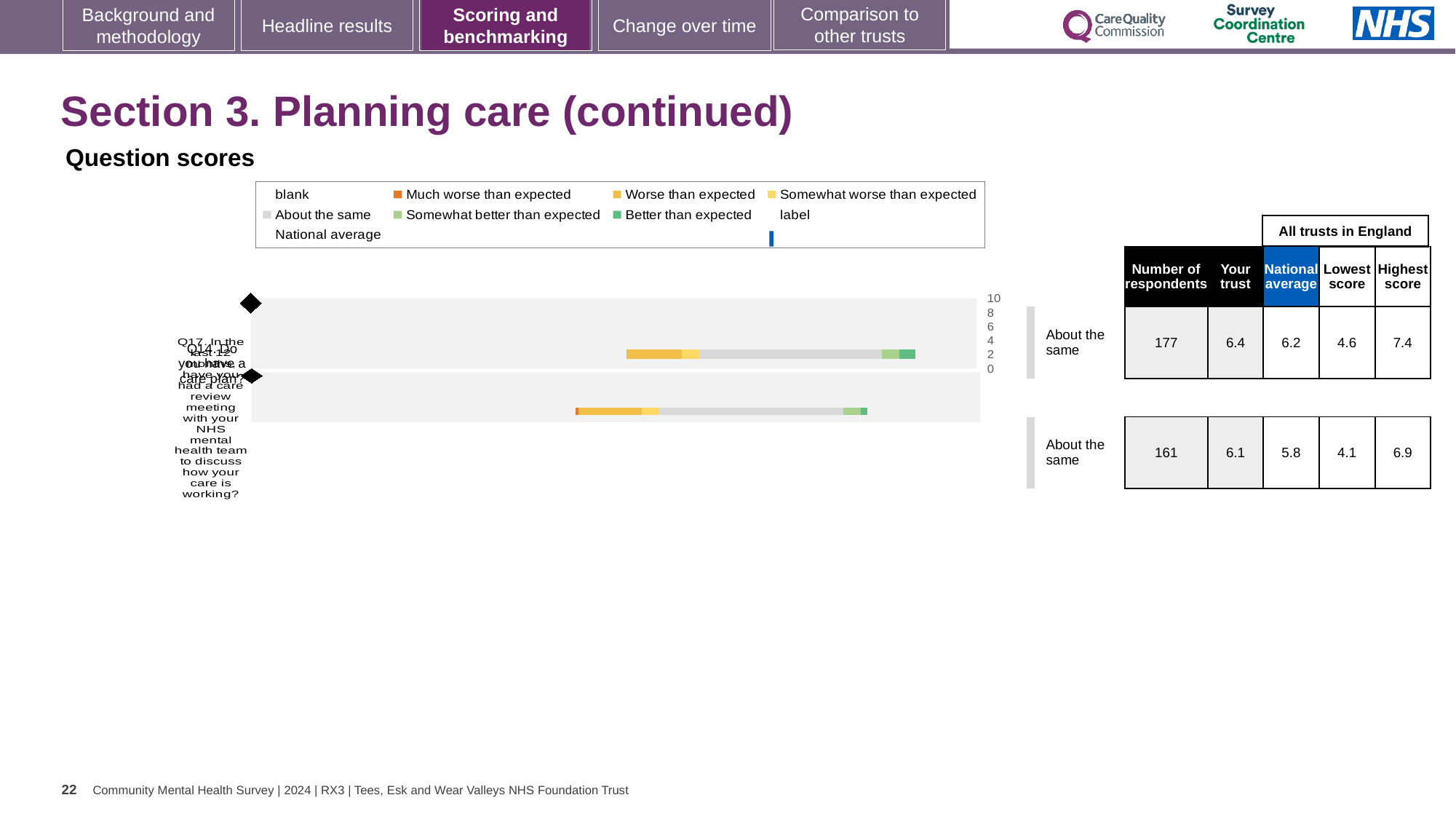
What benchmark category is given for both questions next to the chart? About the same Which question has the higher 'Your trust' score in the table, Q14 or Q17? Q14 In the table beside the chart, what is the national average for the second question (Q17)? 5.8 In the table beside the chart, what is the highest score across all trusts in England for the second question (Q17)? 6.9 What is the difference between the 'Your trust' score and the national average for the first question (Q14) in the table? 0.2 What is the maximum value shown on the chart's axis? 10 In the table beside the chart, what is the lowest score across all trusts in England for the first question (Q14)? 4.6 In the table beside the chart, what is the 'Your trust' score for the first question (Q14)? 6.4 What kind of chart is shown on the slide? bar chart In the table beside the chart, what is the number of respondents for the first question (Q14)? 177 Which legend entry is shown in blue? National average How many questions (bars) are plotted in the chart? 2